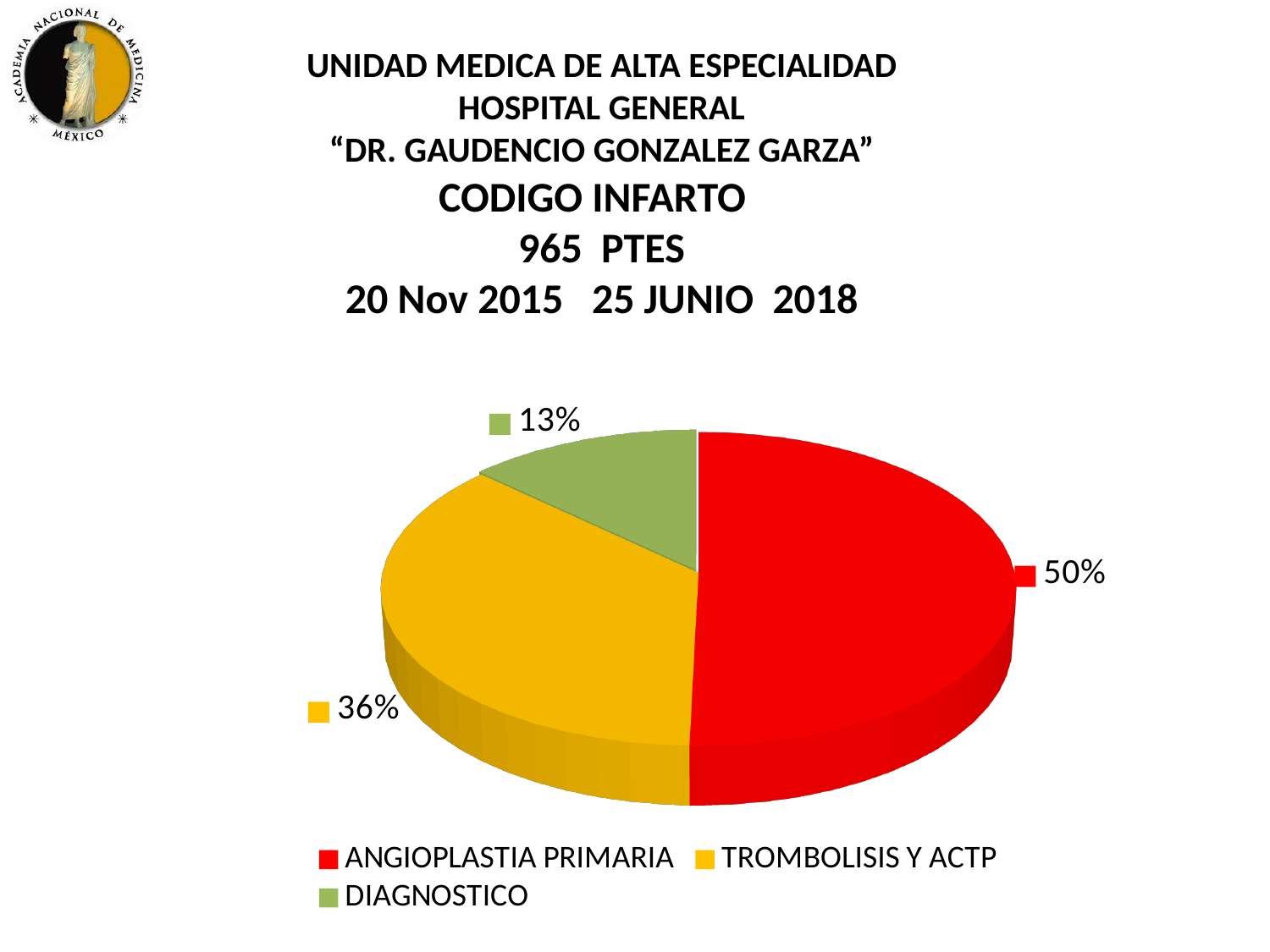
What is the difference in percentage points between ANGIOPLASTIA PRIMARIA and TROMBOLISIS Y ACTP? 14 What percentage of the pie is ANGIOPLASTIA PRIMARIA? 50% What percentage of the pie is DIAGNOSTICO? 13% Which category has the smallest share of the pie? DIAGNOSTICO How many patients (PTES) does the slide title state? 965 Which is larger, the share for TROMBOLISIS Y ACTP or the share for DIAGNOSTICO? TROMBOLISIS Y ACTP What is the difference in percentage points between TROMBOLISIS Y ACTP and DIAGNOSTICO? 23 How many categories does the pie chart have? 3 What kind of chart is shown on the slide? Pie chart Which category has the largest share of the pie? ANGIOPLASTIA PRIMARIA What colour is the slice for DIAGNOSTICO? Green What percentage of the pie is TROMBOLISIS Y ACTP? 36%